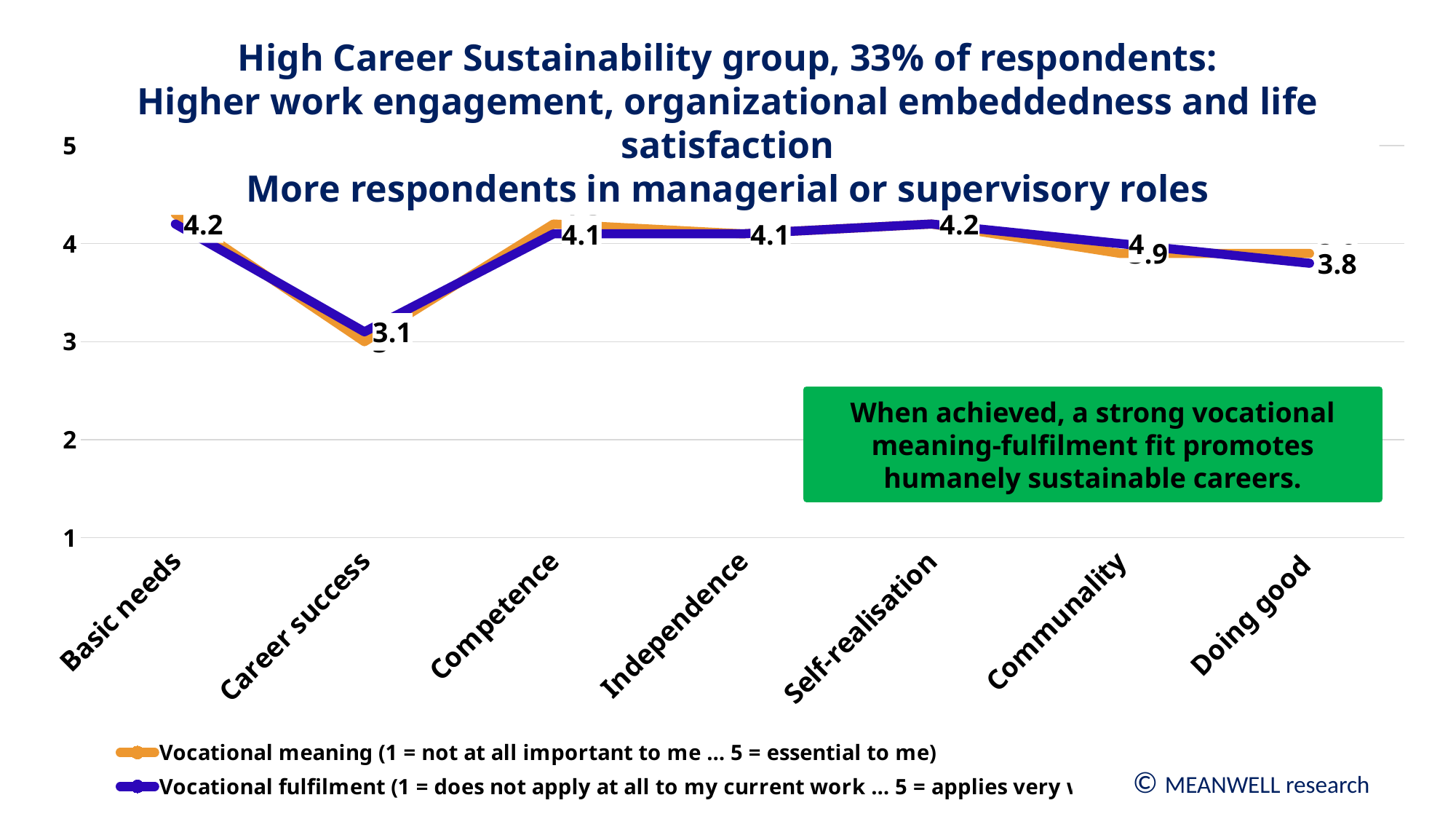
How many categories are plotted along the x axis? 7 What data label is shown at Self-realisation? 4.2 Is the value for Basic needs greater or less than 4? greater Is the value for Career success greater or less than 4? less Which series is drawn in orange according to the legend? Vocational meaning Do the values rise or fall from Basic needs to Career success? fall Which is larger, the value for Self-realisation or the value for Doing good? Self-realisation What kind of chart is shown on the slide? line chart How many series does the legend list? 2 What data label is shown at Doing good? 3.8 What data label is shown at Career success? 3.1 Which category has the lowest values on the chart? Career success